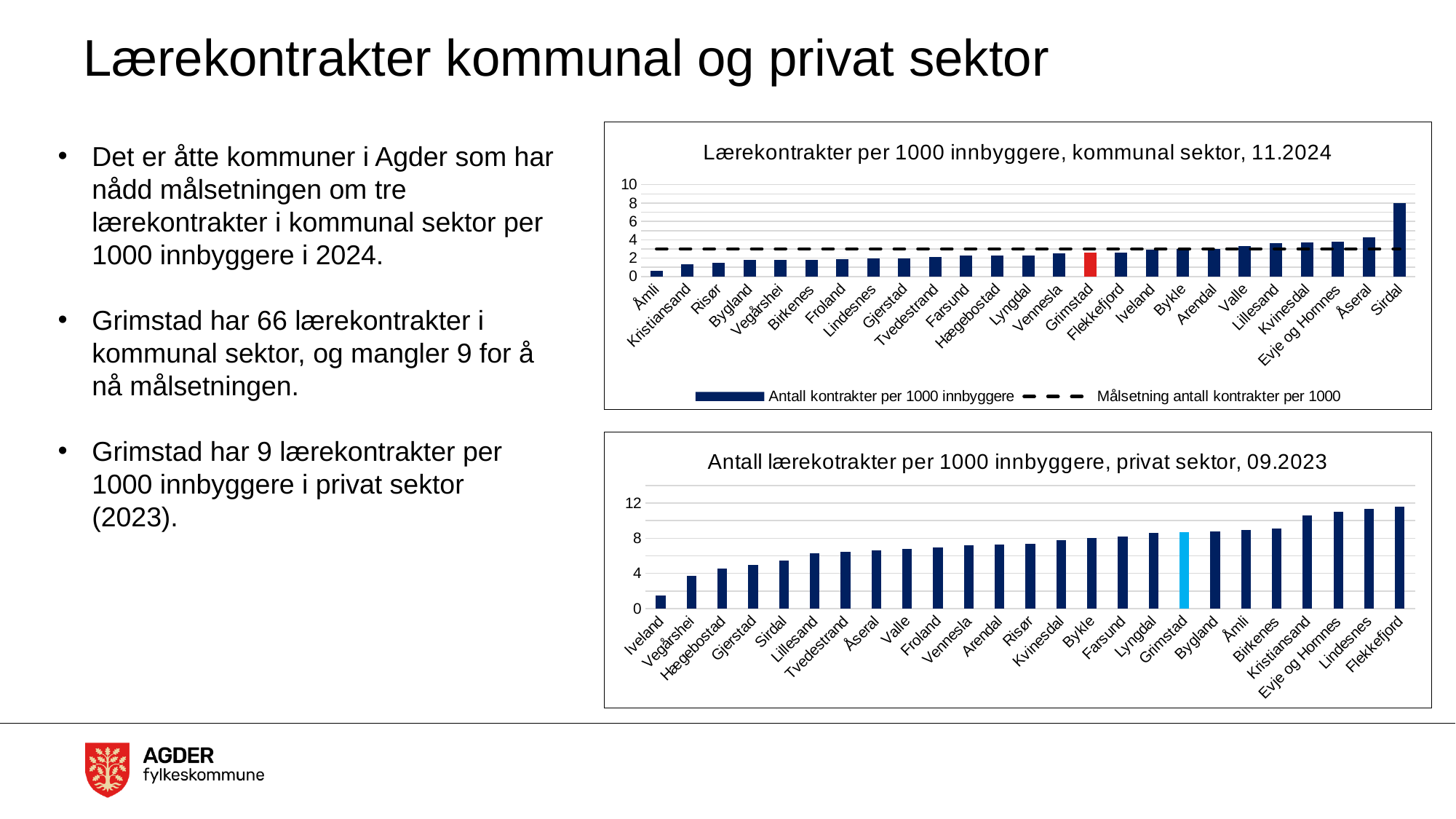
In the top chart (kommunal sektor), which is larger, the value for Sirdal or the value for Åseral? Sirdal How many series does the legend of the top chart (kommunal sektor) list? 2 In the bottom chart (privat sektor), is the value for Iveland greater or less than 4? less In the top chart (kommunal sektor), is the value for Åmli greater or less than 2? less What type of chart is the bottom chart (privat sektor)? Bar chart How many municipalities are shown in the bottom chart (privat sektor)? 25 In the top chart (kommunal sektor), is the value for Sirdal greater or less than 6? greater In the bottom chart (privat sektor), which municipality has the lowest value? Iveland In the top chart (kommunal sektor), which municipality has the lowest value? Åmli In the top chart (kommunal sektor), which municipality has the highest number of lærekontrakter per 1000 innbyggere? Sirdal In the bottom chart (privat sektor), which municipality has the highest value? Flekkefjord